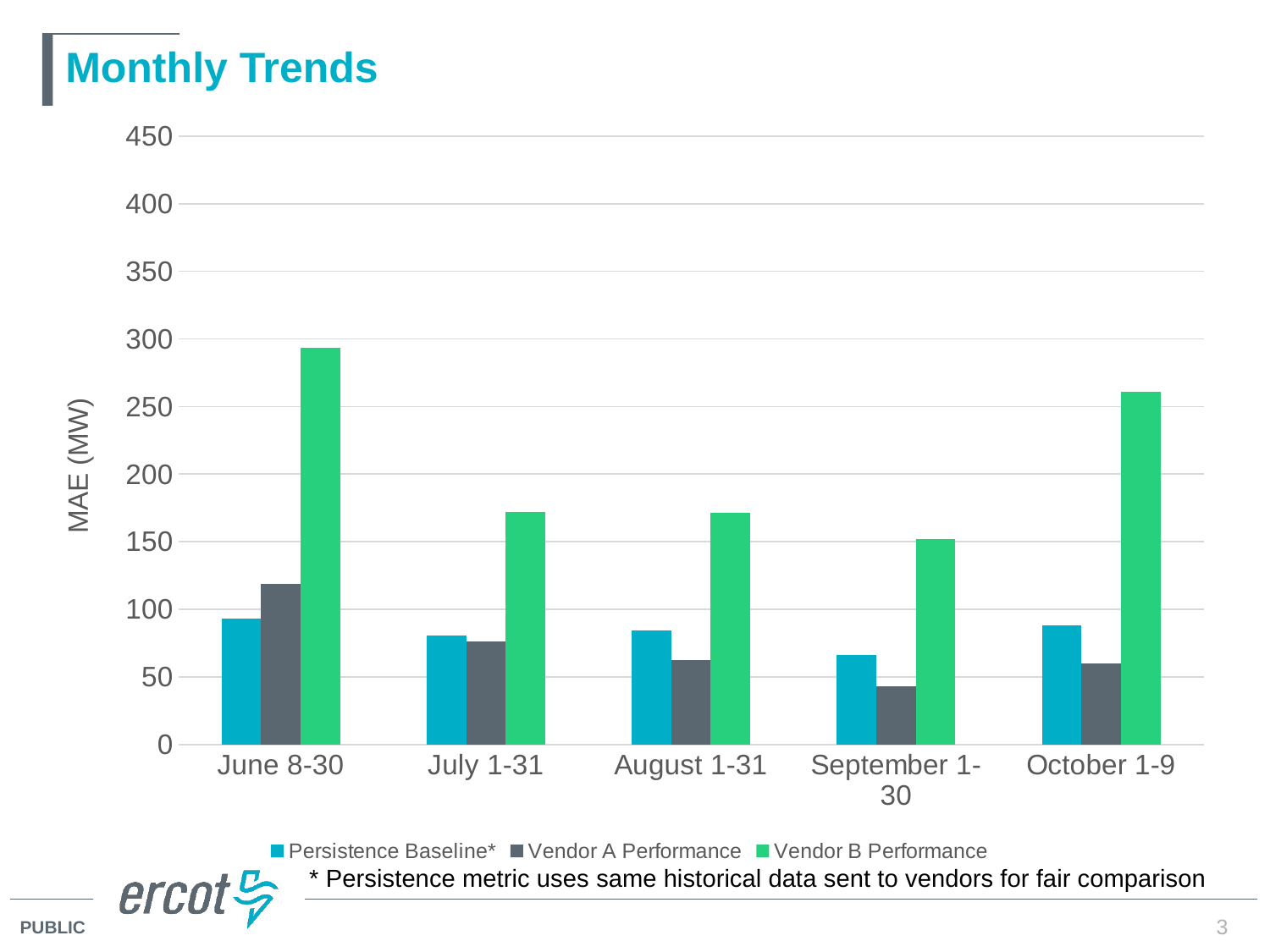
What kind of chart is shown on the slide? bar chart How many series does the legend list? 3 What is the label on the y axis? MAE (MW) Is the Vendor A Performance value for September 1-30 greater or less than 50? less Is the Vendor B Performance value for June 8-30 greater or less than 250? greater Is the Persistence Baseline value for October 1-9 greater or less than 100? less How many month categories are shown on the x axis? 5 In which month is the Vendor A Performance bar the lowest? September 1-30 Does the Vendor B Performance value rise or fall from June 8-30 to September 1-30? fall Which is larger: Vendor B Performance for October 1-9 or Vendor B Performance for August 1-31? October 1-9 For June 8-30, which is larger: Persistence Baseline or Vendor A Performance? Vendor A Performance In which month is the Vendor B Performance bar the highest? June 8-30